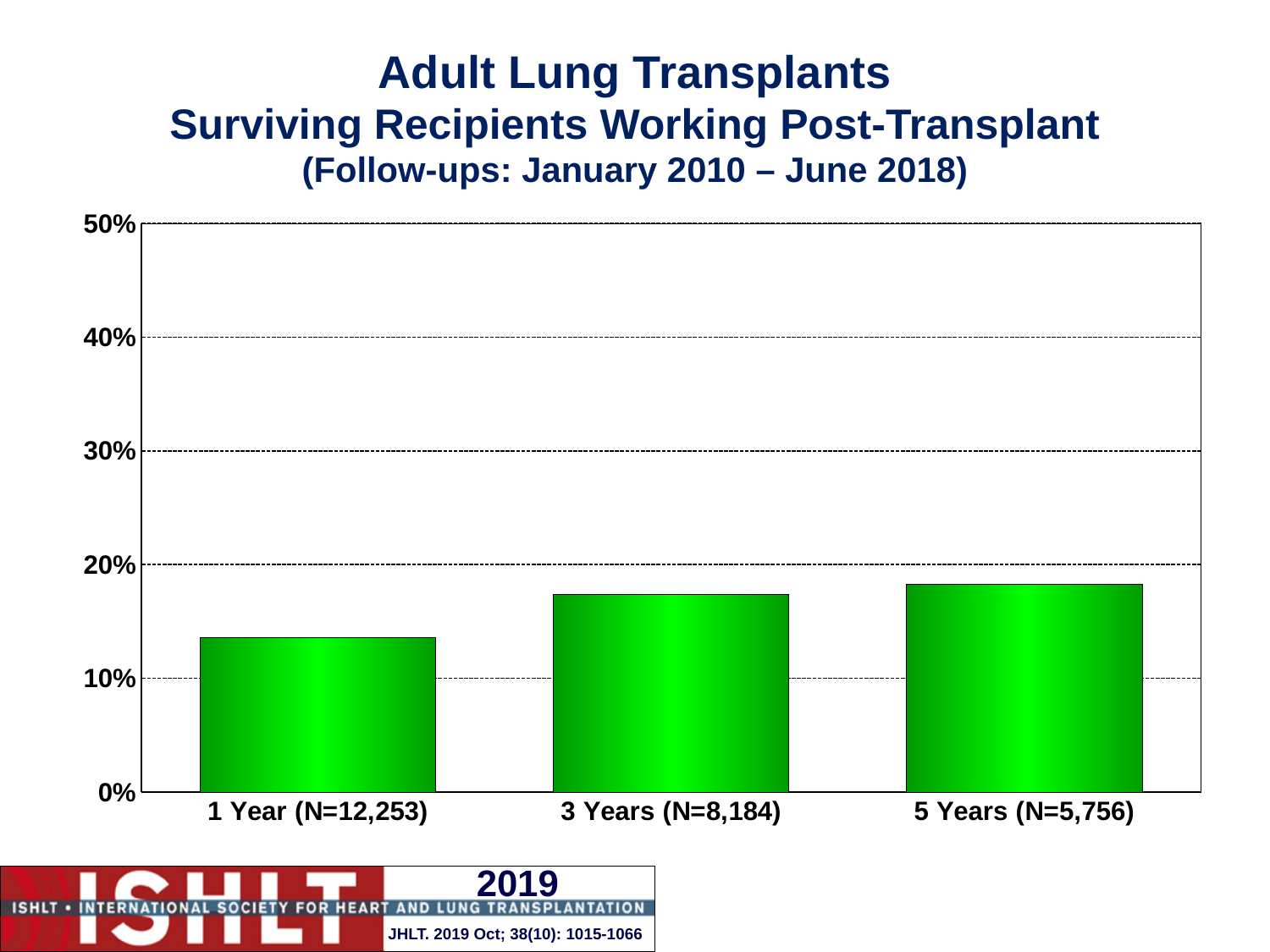
Is the value for 1 Year (N=12,253) greater or less than 20%? less Do the values rise or fall as the follow-up time increases from 1 Year to 5 Years? rise Is the value for 5 Years (N=5,756) greater or less than 10%? greater Which follow-up time point has the lowest percentage of surviving recipients working post-transplant? 1 Year (N=12,253) Which follow-up time point has the highest percentage of surviving recipients working post-transplant? 5 Years (N=5,756) What follow-up period is stated in the chart title? January 2010 – June 2018 How many categories (follow-up time points) are shown on the x axis? 3 What kind of chart is shown on the slide? bar chart Is the value for 3 Years (N=8,184) greater or less than 20%? less What is the N (number of recipients) shown for the 3 Years category? 8,184 Which is larger, the value for 1 Year or the value for 3 Years? 3 Years